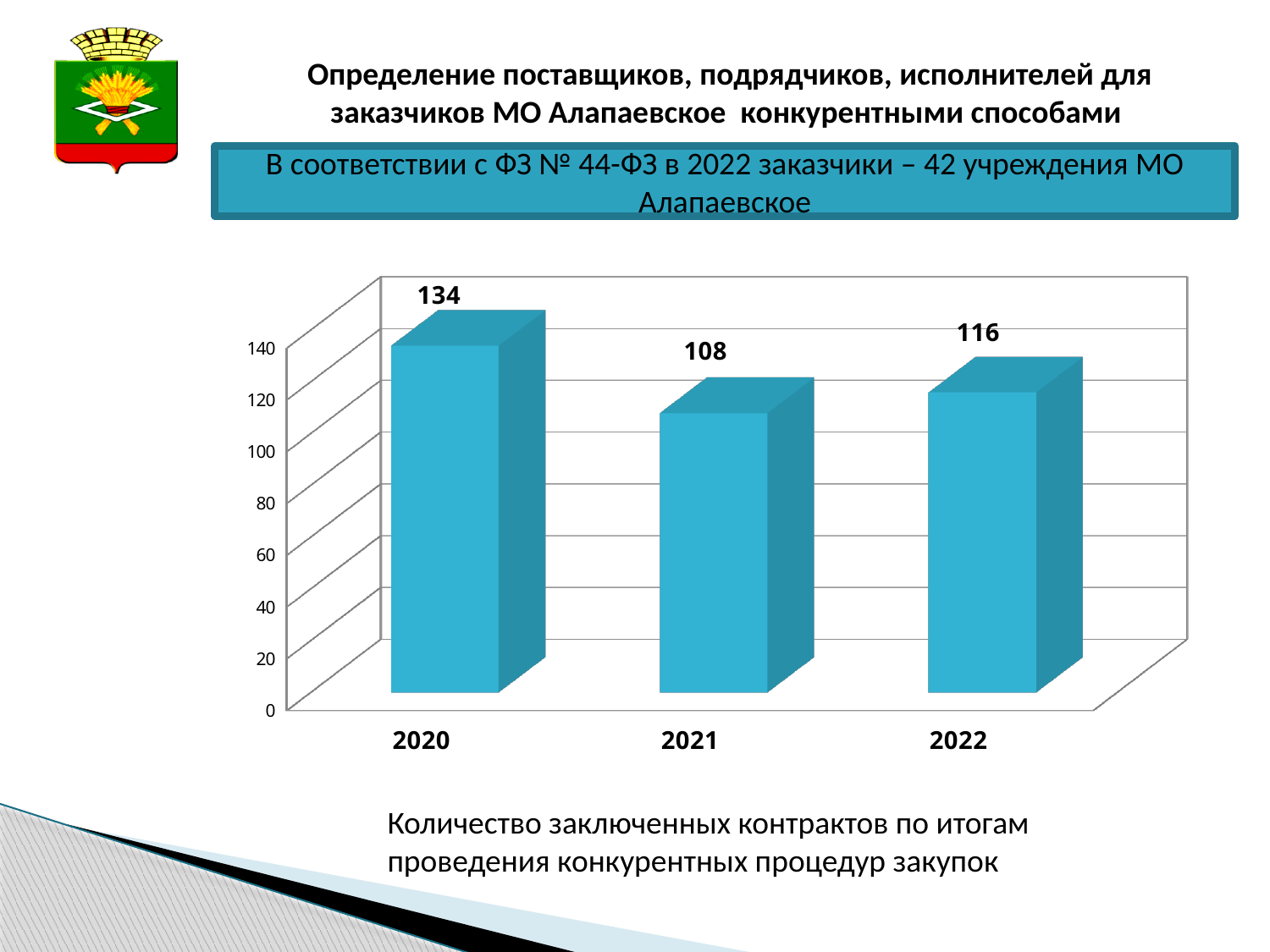
What is the value for 2021? 108 Is the value for 2021 greater or less than 120? less What is the value for 2020? 134 Which is larger, the value for 2021 or the value for 2022? 2022 What is the difference between the values for 2020 and 2021? 26 Does the value rise or fall from 2020 to 2021? fall Which year has the highest value? 2020 What is the difference between the values for 2022 and 2021? 8 How many years are shown on the x axis? 3 Which year has the lowest value? 2021 What kind of chart is shown on the slide? bar chart What is the value for 2022? 116